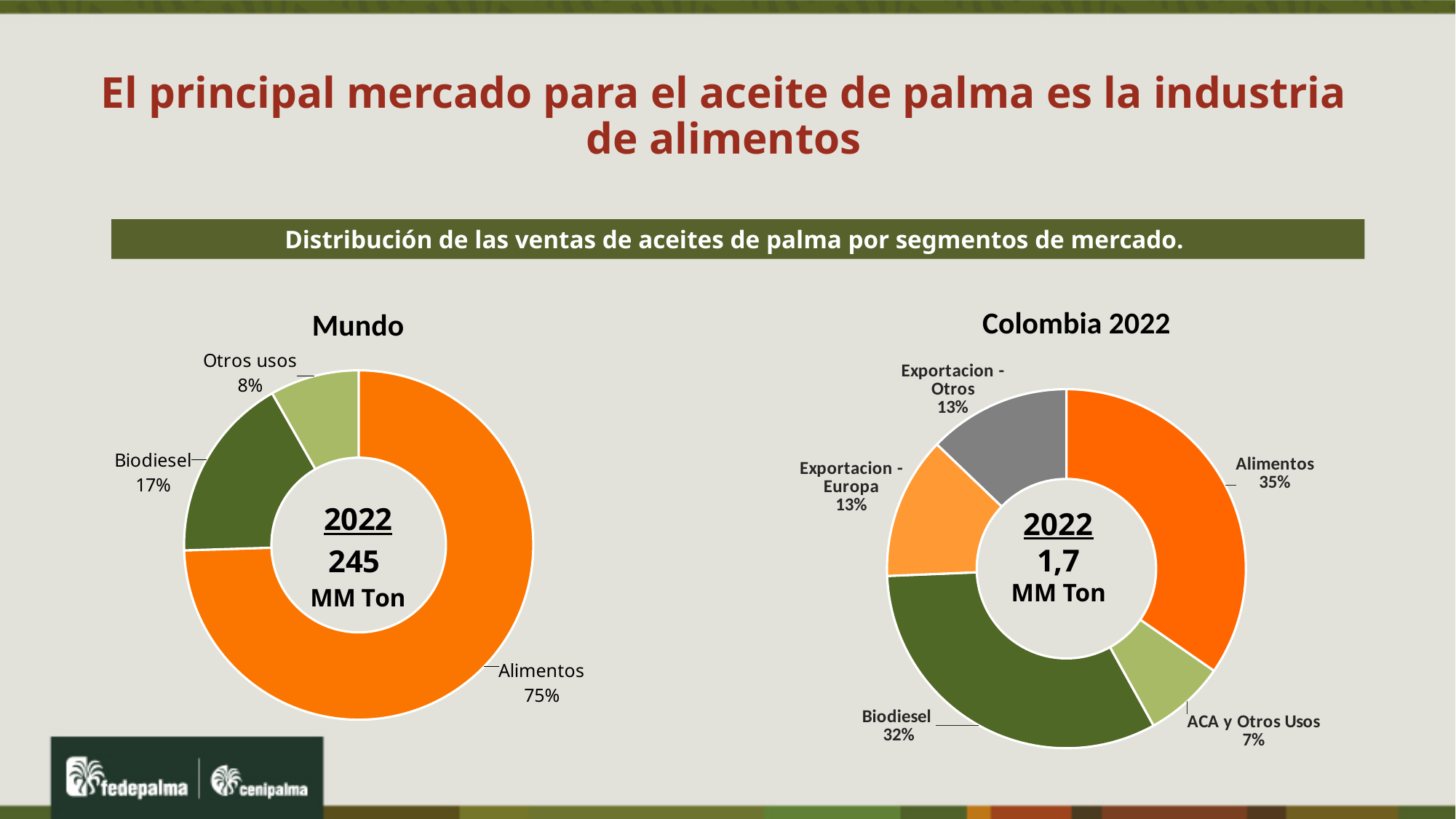
In the Mundo chart, which segment has the smallest share? Otros usos In the Mundo chart, what is the difference between the Alimentos and Biodiesel shares? 58% What kind of chart is the Mundo chart? Doughnut chart In the Mundo chart, what share does Biodiesel have? 17% In the Colombia 2022 chart, how many segments are shown? 5 In the Colombia 2022 chart, what share does Biodiesel have? 32% In the Colombia 2022 chart, which segment has the largest share? Alimentos What total volume in MM Ton is shown in the centre of the Colombia 2022 chart? 1,7 MM Ton In the Mundo chart, what share does Alimentos have? 75% In the Colombia 2022 chart, which is larger, Alimentos or Biodiesel? Alimentos In the Colombia 2022 chart, what share does ACA y Otros Usos have? 7% In the Mundo chart, how many segments are shown? 3